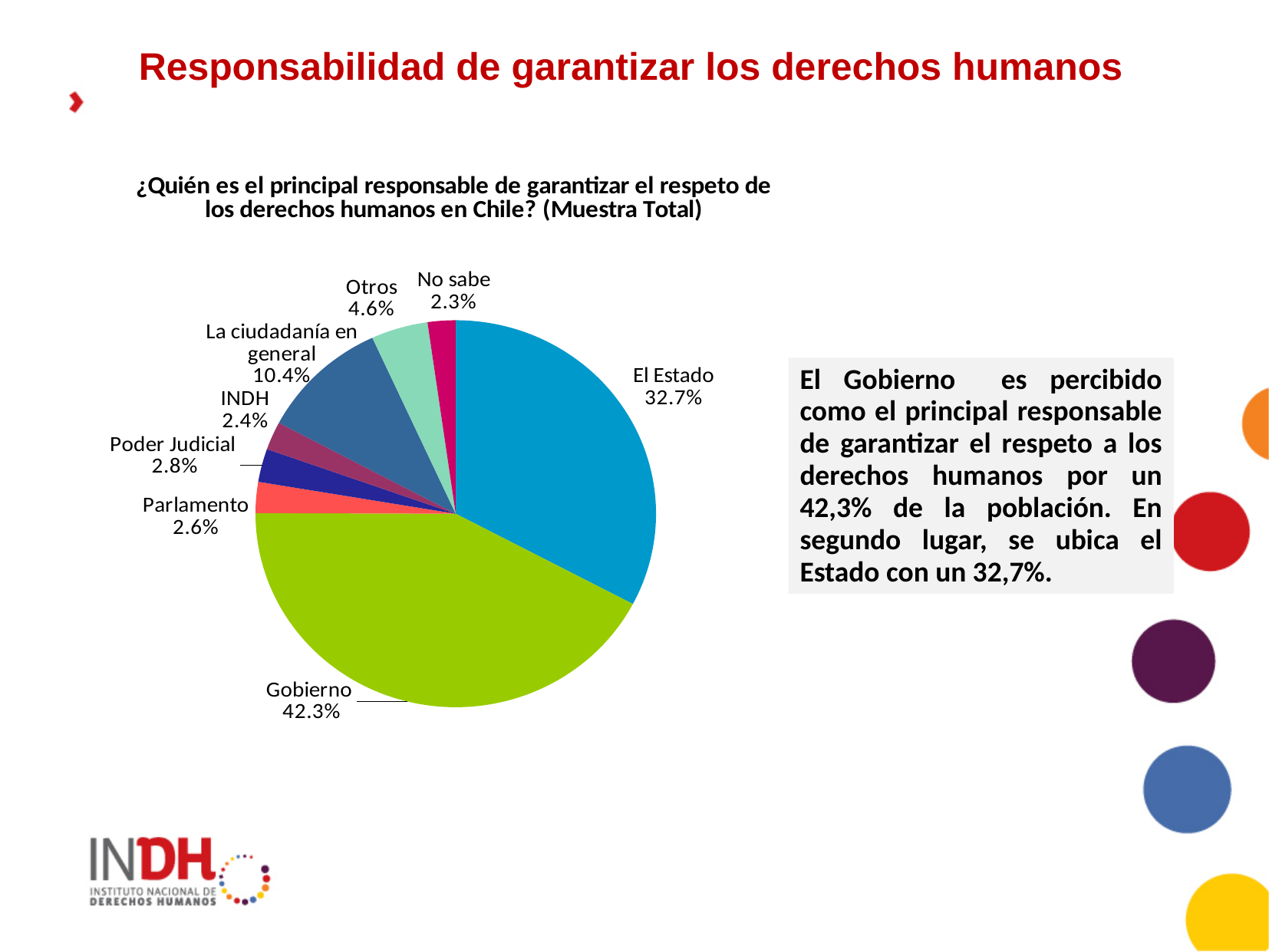
What is the title of the pie chart? ¿Quién es el principal responsable de garantizar el respeto de los derechos humanos en Chile? (Muestra Total) What is the difference in percentage points between Gobierno and El Estado? 9.6 Which category has the smallest slice of the pie? No sabe How many categories are shown in the pie chart? 8 What percentage of respondents named Gobierno as the main responsible party? 42.3% What share is shown for La ciudadanía en general? 10.4% What is the value shown for El Estado? 32.7% What kind of chart is shown on the slide? Pie chart Which is larger, the slice for Otros or the slice for INDH? Otros What is the value for No sabe? 2.3% Which category has the largest slice of the pie? Gobierno What percentage is shown for Poder Judicial? 2.8%